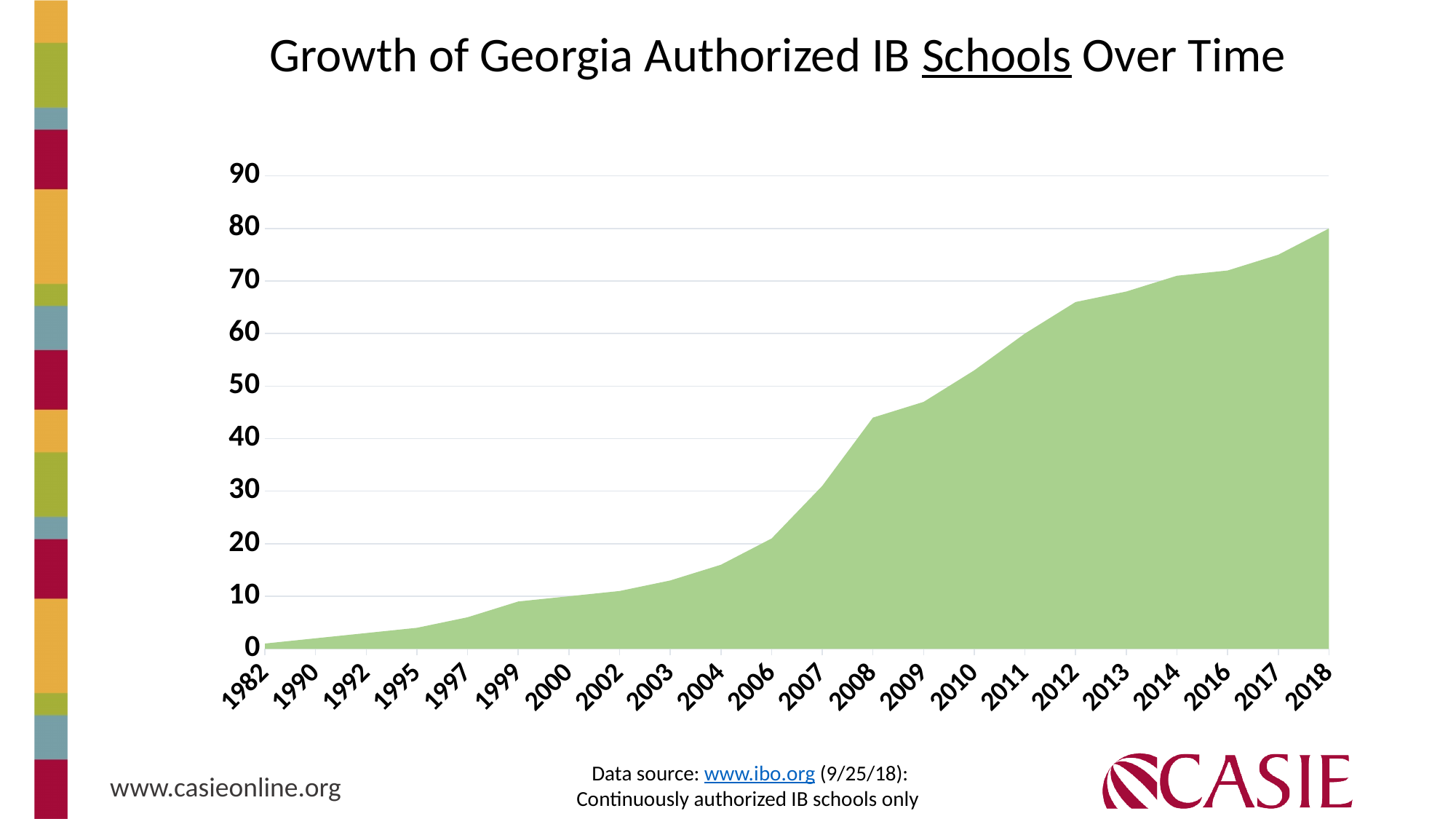
How many years are labelled on the x axis of the chart? 22 Is the value for 1997 greater or less than 10? less Do the values rise or fall from 1982 to 2018? rise Is the value for 2006 greater or less than 30? less Is the value for 2008 greater or less than 40? greater What is the title of the chart? Growth of Georgia Authorized IB Schools Over Time Which year has the highest number of authorized IB schools? 2018 Which year has a larger value, 2008 or 2012? 2012 Which year has the lowest number of authorized IB schools? 1982 What kind of chart is shown on the slide? area chart